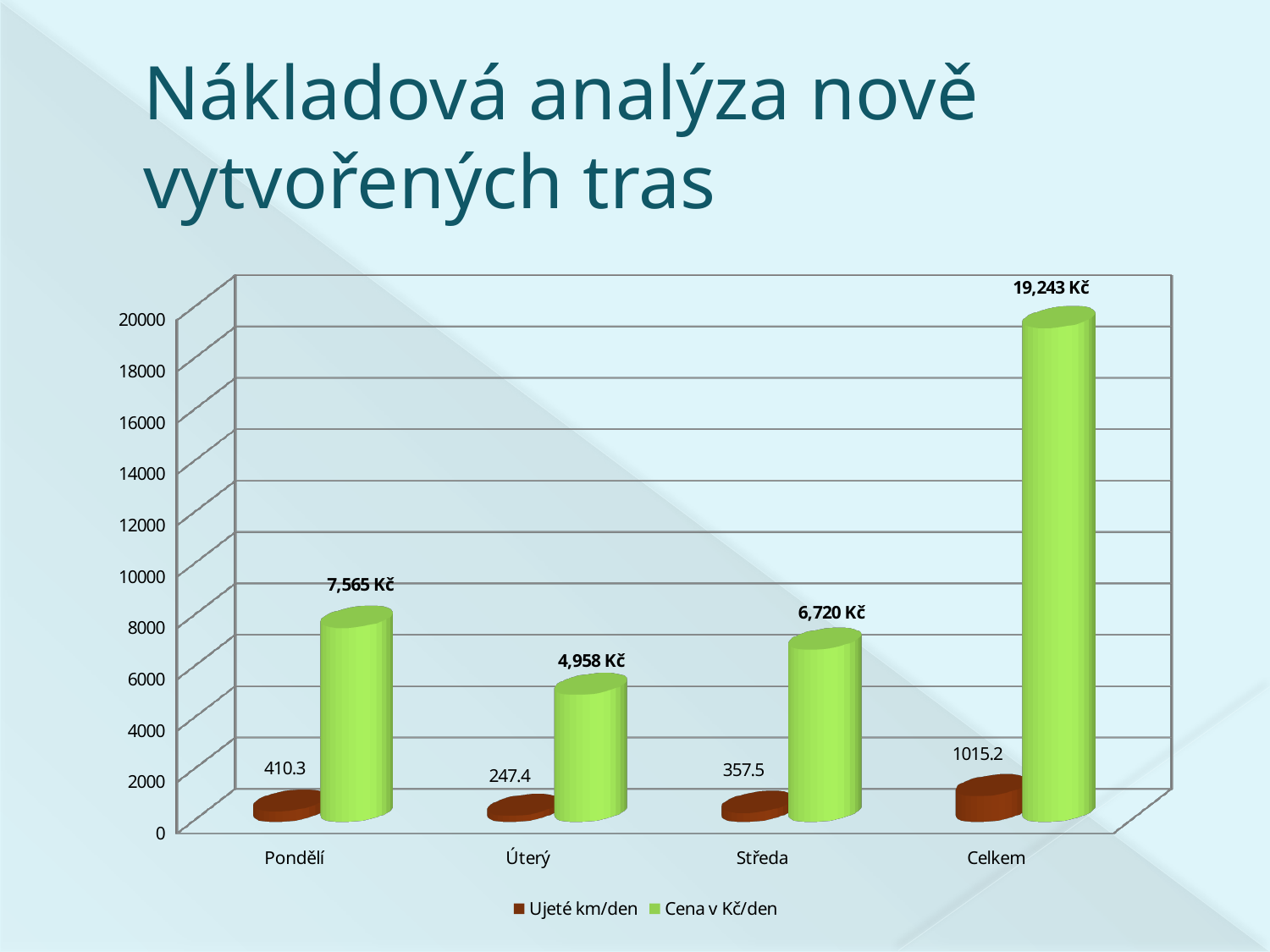
What is the value of Cena v Kč/den for Pondělí? 7,565 Kč What kind of chart is shown on the slide? bar chart Which has a higher Ujeté km/den, Pondělí or Středa? Pondělí Which category has the lowest Cena v Kč/den? Úterý How many categories are shown on the x axis? 4 What is the value of Ujeté km/den for Středa? 357.5 Which category has the highest Ujeté km/den? Celkem Is the Cena v Kč/den for Středa greater or less than 8000? less How many series does the legend list? 2 What is the value of Ujeté km/den for Úterý? 247.4 What is the value of Cena v Kč/den for Celkem? 19,243 Kč What is the difference in Cena v Kč/den between Pondělí and Středa? 845 Kč